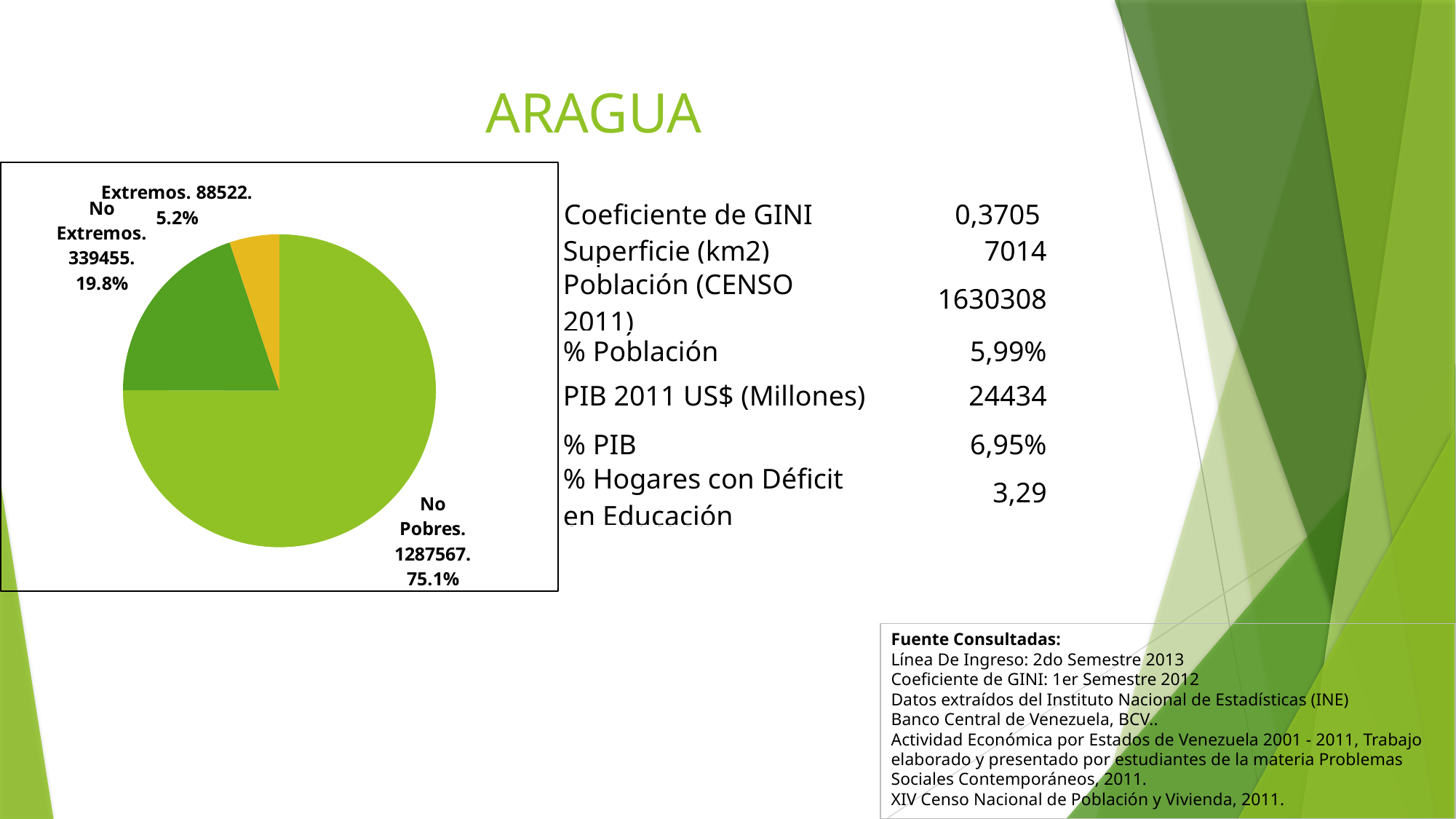
What colour is the Extremos slice in the pie chart? yellow What is the value for Extremos in the pie chart? 88522 What is the value for No Pobres in the pie chart? 1287567 What is the value for No Extremos in the pie chart? 339455 How many slices does the pie chart have? 3 Which slice of the pie chart is the smallest? Extremos What kind of chart is shown on the slide? pie chart What is the difference between the No Extremos value and the Extremos value? 250933 What share of the pie does Extremos represent? 5.2% Which is larger, the No Extremos slice or the Extremos slice? No Extremos Which slice of the pie chart is the largest? No Pobres What share of the pie does No Pobres represent? 75.1%